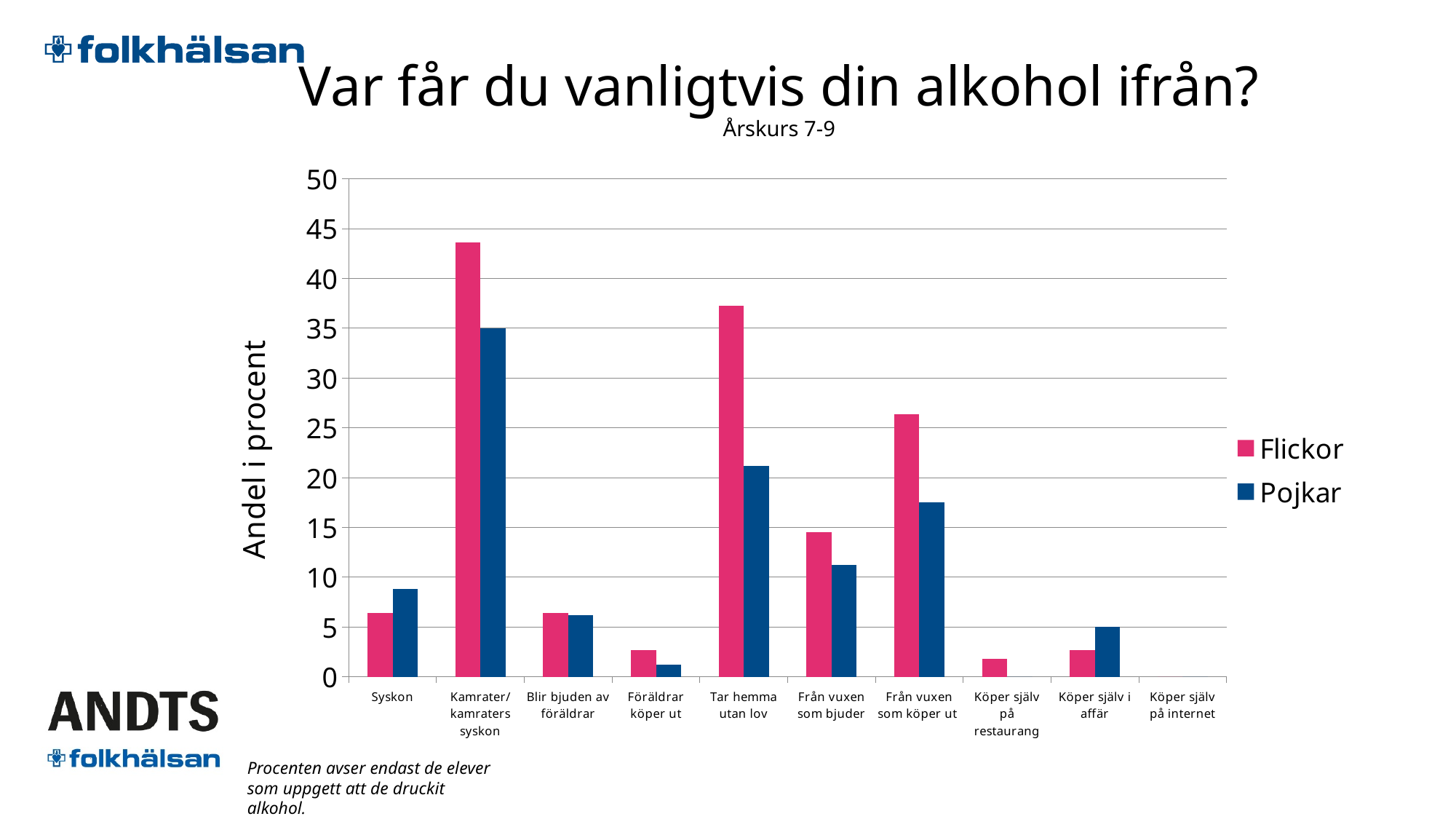
How many series does the legend list? 2 How many categories are shown on the x axis? 10 Is the Flickor value for Tar hemma utan lov greater or less than 35? greater For Köper själv i affär, which series has the larger value, Flickor or Pojkar? Pojkar Which category has the highest value for Flickor? Kamrater/kamraters syskon Which category has the highest value for Pojkar? Kamrater/kamraters syskon Is the Pojkar value for Tar hemma utan lov greater or less than 20? greater What kind of chart is shown on the slide? bar chart What is the label of the y axis? Andel i procent Is the Flickor value for Kamrater/kamraters syskon greater or less than 40? greater For Syskon, which series has the larger value, Flickor or Pojkar? Pojkar